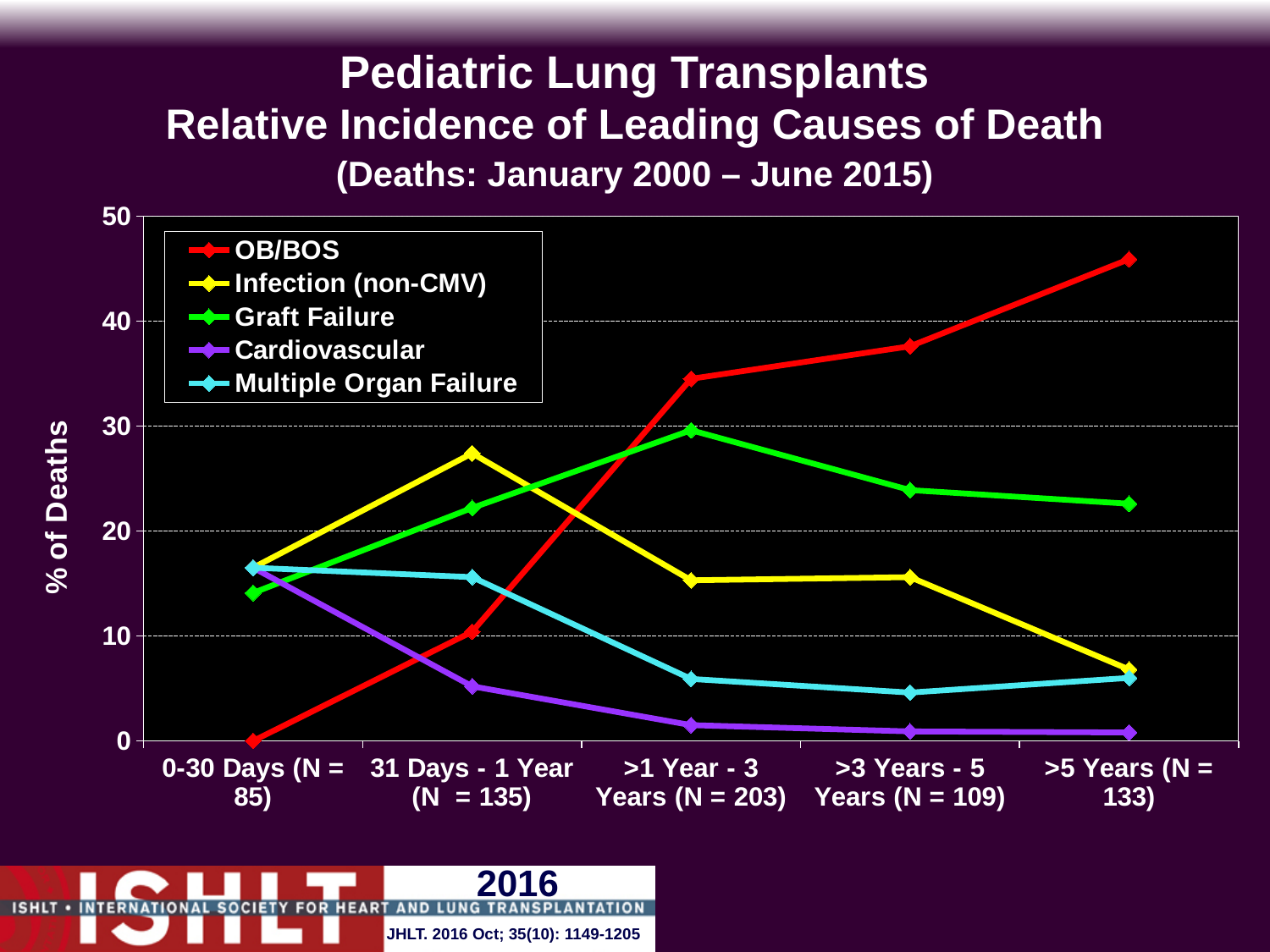
In the >1 Year - 3 Years (N = 203) period, which is larger: OB/BOS or Graft Failure? OB/BOS What is the % of deaths for OB/BOS in the 0-30 Days (N = 85) period? 0 Is the value for Multiple Organ Failure in the >3 Years - 5 Years (N = 109) period greater or less than 10? less Which cause of death has the highest % of deaths in the 31 Days - 1 Year (N = 135) period? Infection (non-CMV) How many time-period categories are shown on the x axis? 5 Is the value for OB/BOS in the >5 Years (N = 133) period greater or less than 40? greater Does the OB/BOS line rise or fall across the time periods from left to right? rise Which cause of death has the highest % of deaths in the >5 Years (N = 133) period? OB/BOS What kind of chart is shown on the slide? line chart Is the value for Infection (non-CMV) in the 31 Days - 1 Year (N = 135) period greater or less than 20? greater How many series does the legend list? 5 Which cause of death has the lowest % of deaths in the >5 Years (N = 133) period? Cardiovascular